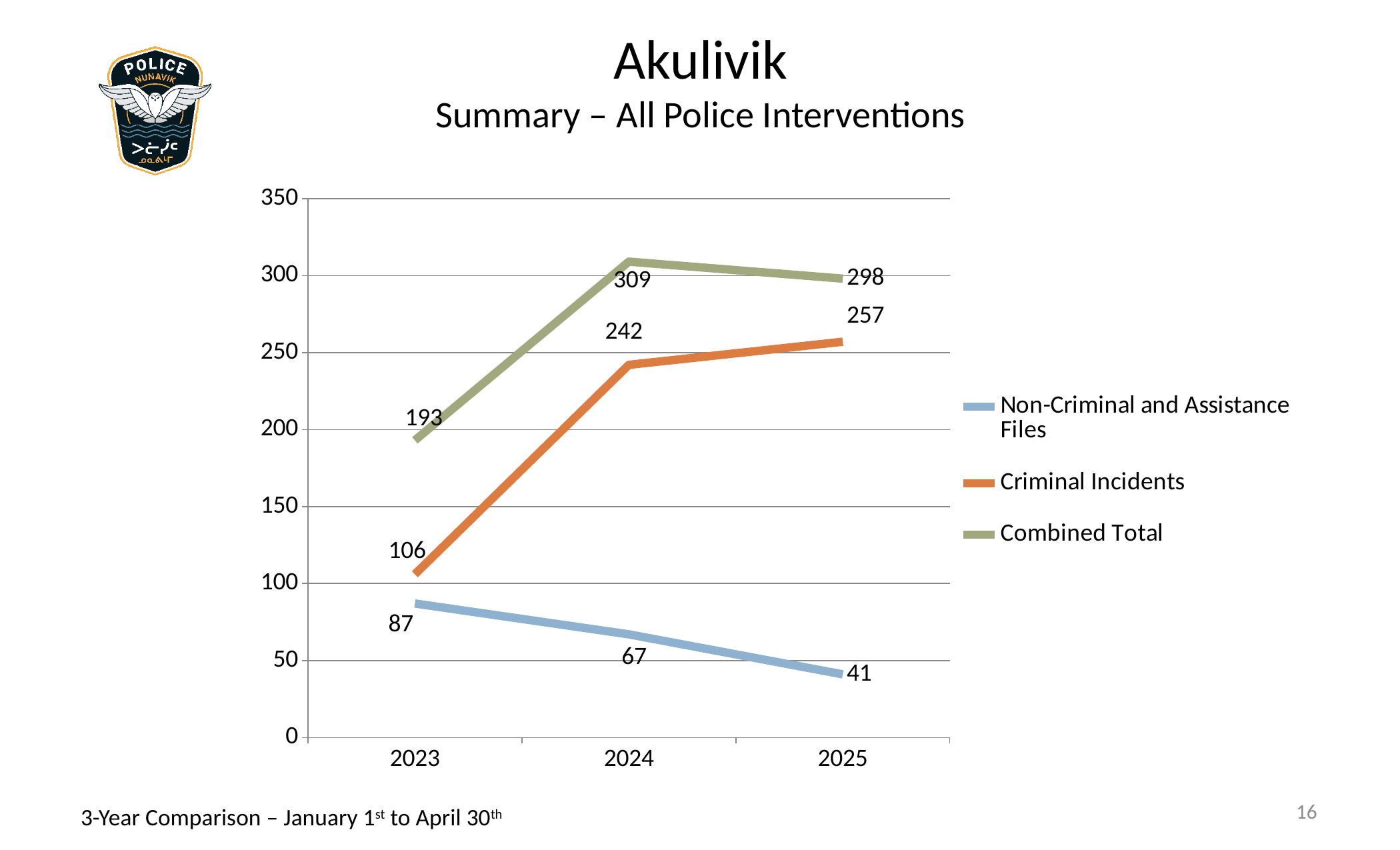
How many years are shown on the x axis? 3 What is the difference between Criminal Incidents in 2025 and in 2023? 151 In which year is the Combined Total highest? 2024 What is the Combined Total for 2023? 193 Do the values for Non-Criminal and Assistance Files rise or fall from 2023 to 2025? fall In which year is the value for Non-Criminal and Assistance Files lowest? 2025 What is the value for Criminal Incidents in 2024? 242 What kind of chart is shown on the slide? line chart Which is larger in 2024: Criminal Incidents or Non-Criminal and Assistance Files? Criminal Incidents Is the Combined Total for 2025 greater or less than 250? greater What is the value for Non-Criminal and Assistance Files in 2025? 41 How many series does the legend list? 3